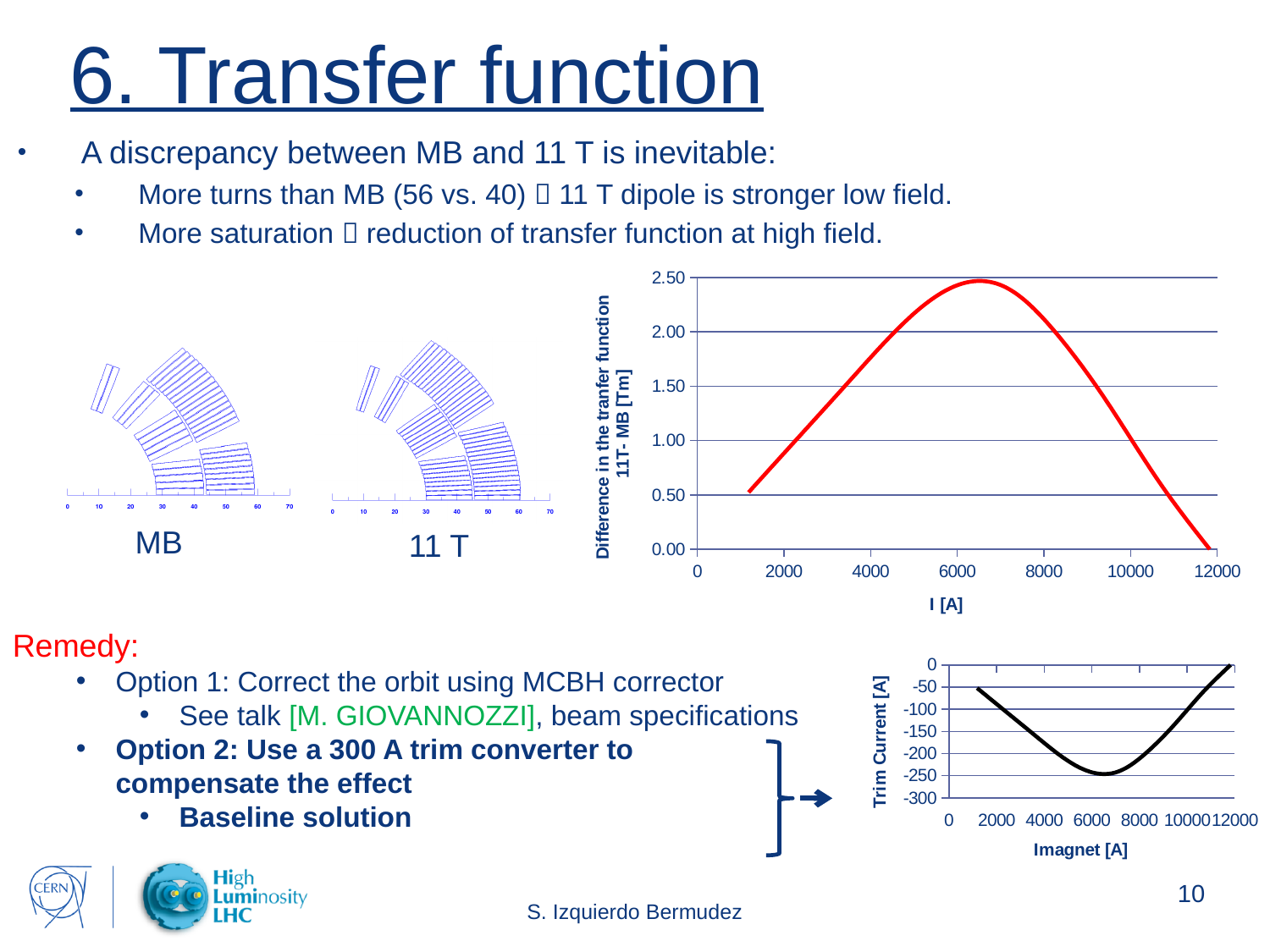
In the top-right chart (Difference in the transfer function 11T-MB), is the value at I = 10000 A greater or less than 1.50? less In the top-right chart (Difference in the transfer function 11T-MB), is the value at I = 8000 A greater or less than 1.50? greater In the top-right chart (Difference in the transfer function 11T-MB), is the value at I = 6000 A greater or less than 2.00? greater In the bottom-right chart (Trim Current vs Imagnet), how does the curve behave as Imagnet increases from 0 to 12000 A? falls to a minimum then rises In the top-right chart (Difference in the transfer function 11T-MB), how does the curve behave as the current increases from 0 to 12000 A? rises to a peak then falls In the bottom-right chart (Trim Current vs Imagnet), which has the larger value: Imagnet = 2000 A or Imagnet = 6000 A? 2000 A What is the x-axis label of the top-right chart (Difference in the transfer function 11T-MB)? I [A] What kind of chart is the bottom-right chart showing Trim Current? line chart In the top-right chart (Difference in the transfer function 11T-MB), which has the larger value: I = 2000 A or I = 6000 A? 6000 A What kind of chart is the top-right chart showing the difference in the transfer function? line chart